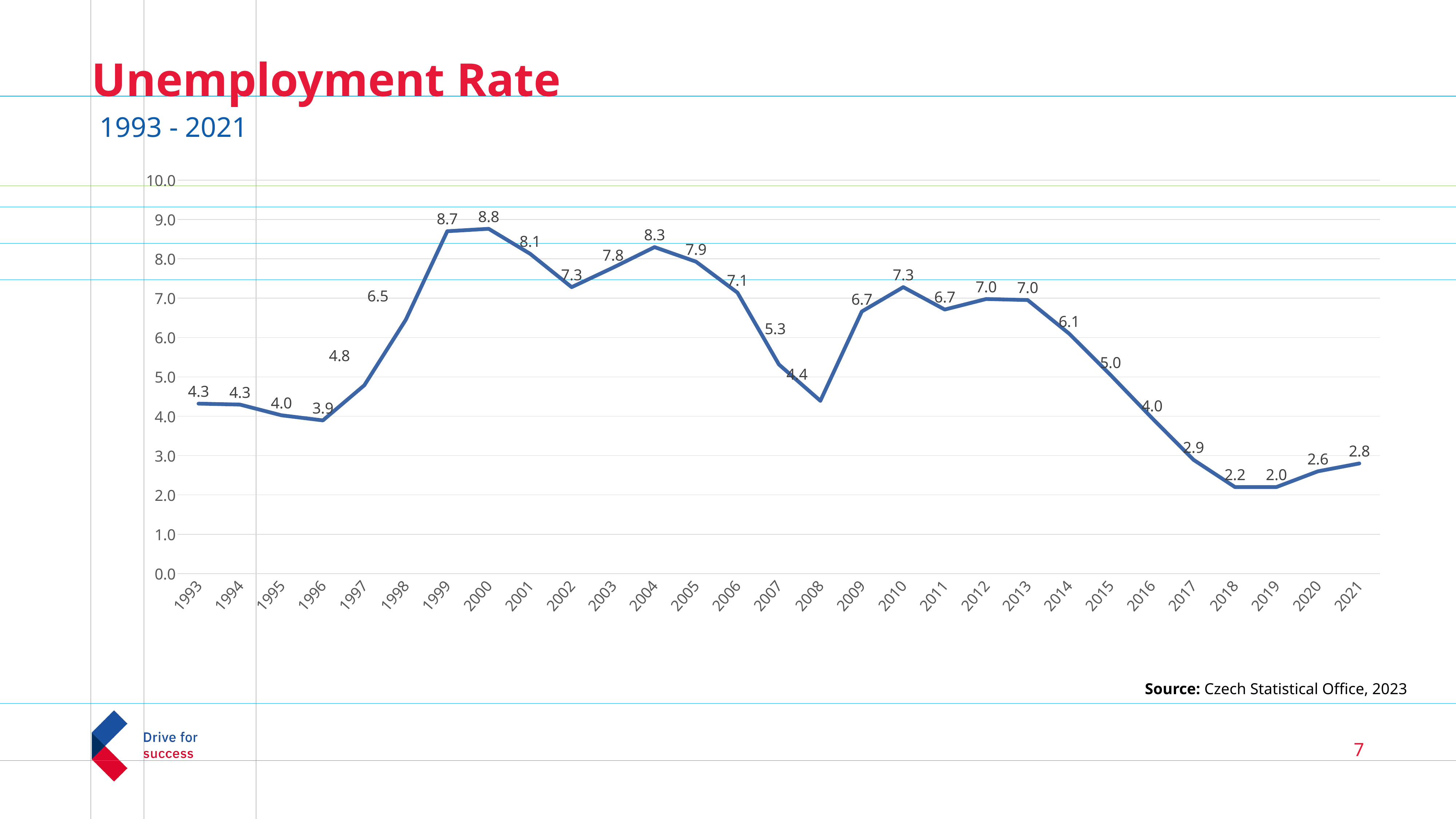
Which year has the lowest unemployment rate on the chart? 2019 What is the unemployment rate shown for 2021? 2.8 What kind of chart is shown on the slide? line chart What is the difference between the unemployment rate in 2004 and in 2008? 3.9 Which year has a higher unemployment rate, 2010 or 2014? 2010 Which year has the highest unemployment rate on the chart? 2000 Does the unemployment rate rise or fall from 2013 to 2019? fall What is the unemployment rate shown for 2008? 4.4 How many years are plotted on the chart? 29 Is the unemployment rate for 2017 greater or less than 3.0? less What is the unemployment rate shown for 2000? 8.8 What is the difference between the unemployment rate in 1999 and in 1996? 4.8